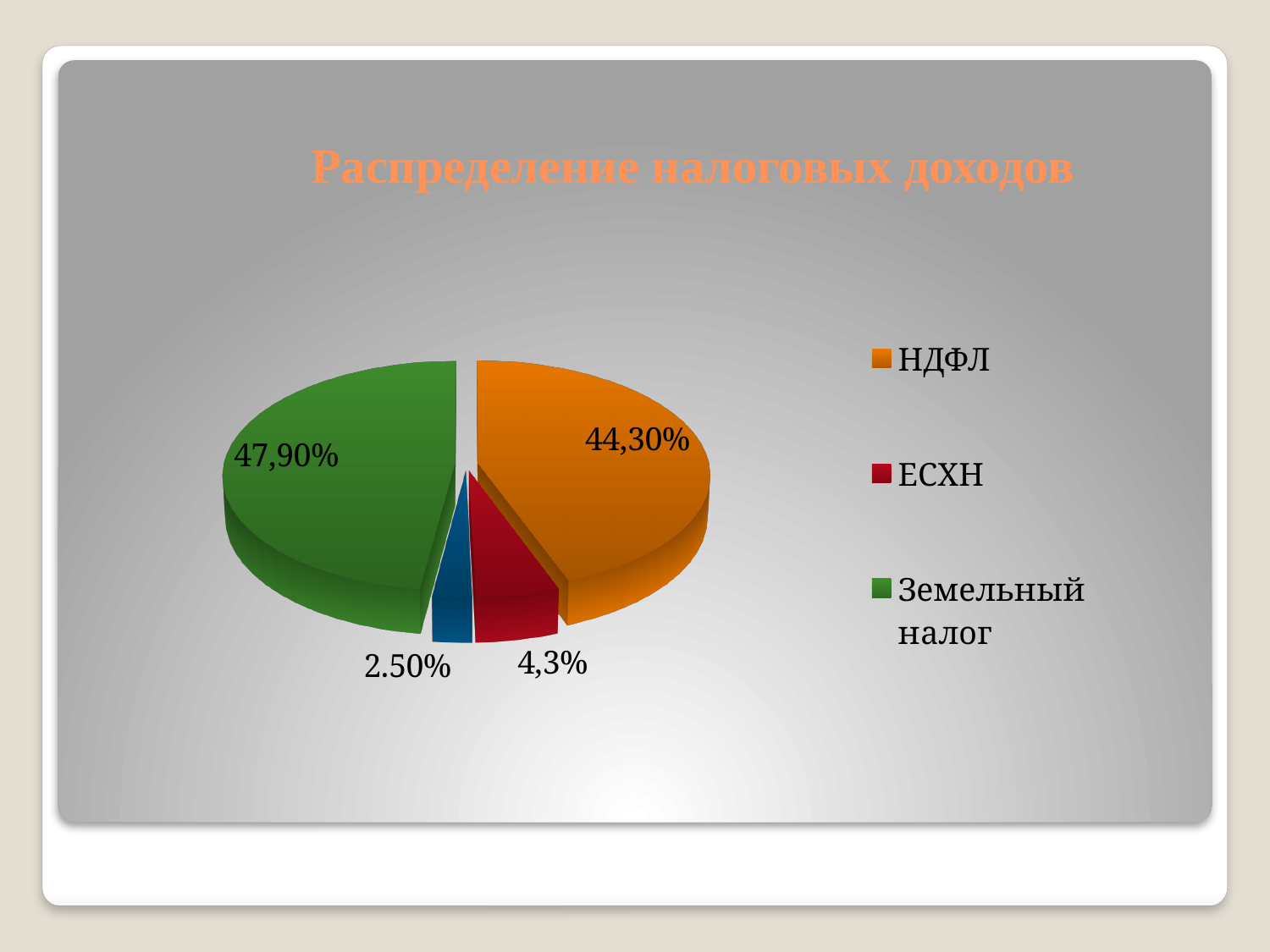
What type of chart is shown on the slide? Pie chart How many slices does the pie chart have? 4 How many entries does the legend list? 3 What is the title of the chart? Распределение налоговых доходов Which category has the largest slice of the pie? Земельный налог By how many percentage points does Земельный налог exceed НДФЛ? 3,60% What is the smallest percentage value labelled on the pie? 2.50% What share of the pie does ЕСХН have? 4,3% What share of the pie does НДФЛ have? 44,30% Which is larger, the slice for НДФЛ or the slice for Земельный налог? Земельный налог What share of the pie does Земельный налог have? 47,90% Which of the categories listed in the legend has the smallest slice? ЕСХН